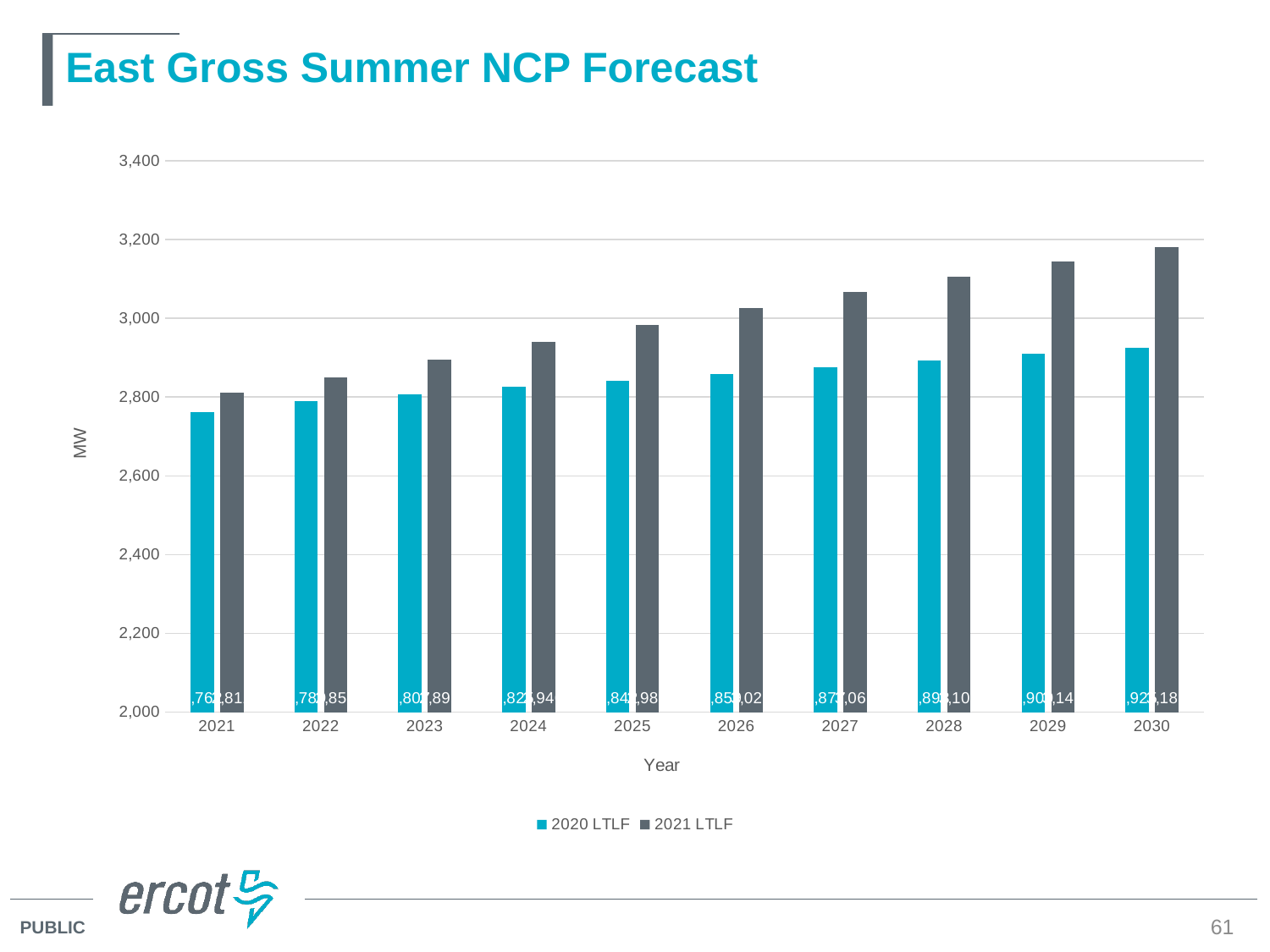
Which year has the lowest 2020 LTLF value? 2021 Do the 2021 LTLF values rise or fall from 2021 to 2030? rise Is the 2021 LTLF value for 2028 greater or less than 3,000? greater Which year has the highest 2021 LTLF value? 2030 Is the 2020 LTLF value for 2021 greater or less than 2,800? less In 2030, which series has the larger value, 2020 LTLF or 2021 LTLF? 2021 LTLF What type of chart is shown on the slide? bar chart Is the 2021 LTLF value for 2030 greater or less than 3,000? greater How many series does the legend list? 2 How many years are shown on the x axis? 10 What is the label on the y axis? MW